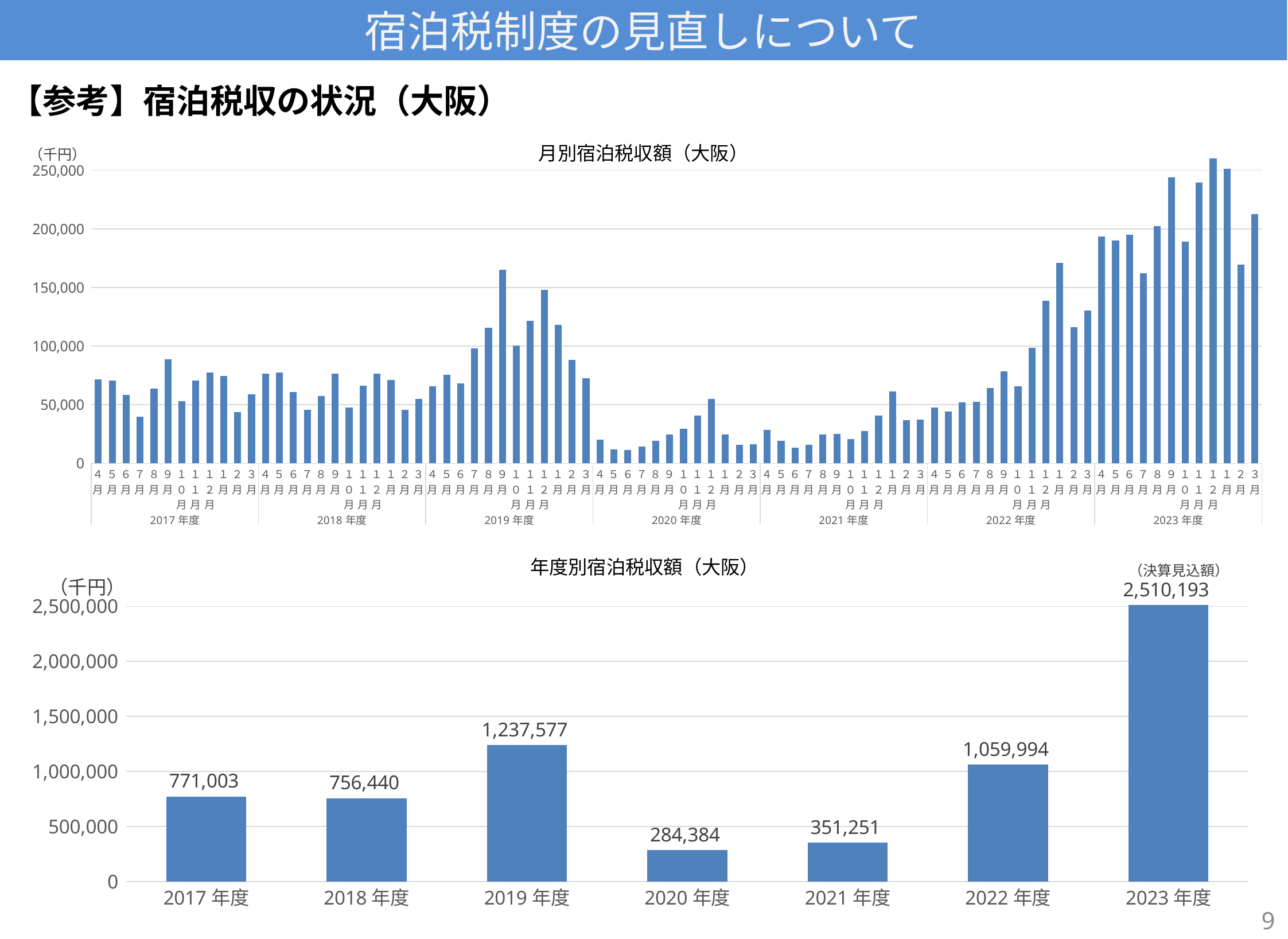
In the 月別宿泊税収額（大阪） chart, is the value for 5月 of 2020 年度 greater or less than 50,000? less In the 年度別宿泊税収額（大阪） chart, which fiscal year has the lowest value? 2020 年度 In the 年度別宿泊税収額（大阪） chart, what is the value for 2019 年度? 1,237,577 In the 年度別宿泊税収額（大阪） chart, what is the difference between the values for 2023 年度 and 2022 年度? 1,450,199 In the 年度別宿泊税収額（大阪） chart, what is the difference between the values for 2021 年度 and 2020 年度? 66,867 In the 月別宿泊税収額（大阪） chart, is the value for 9月 of 2019 年度 greater or less than 150,000? greater How many fiscal years are shown in the 年度別宿泊税収額（大阪） chart? 7 In the 年度別宿泊税収額（大阪） chart, which is larger, the value for 2017 年度 or 2018 年度? 2017 年度 What kind of chart is the 年度別宿泊税収額（大阪） chart? bar chart In the 年度別宿泊税収額（大阪） chart, what is the value for 2020 年度? 284,384 In the 年度別宿泊税収額（大阪） chart, which fiscal year has the highest value? 2023 年度 In the 年度別宿泊税収額（大阪） chart, what is the value for 2023 年度? 2,510,193